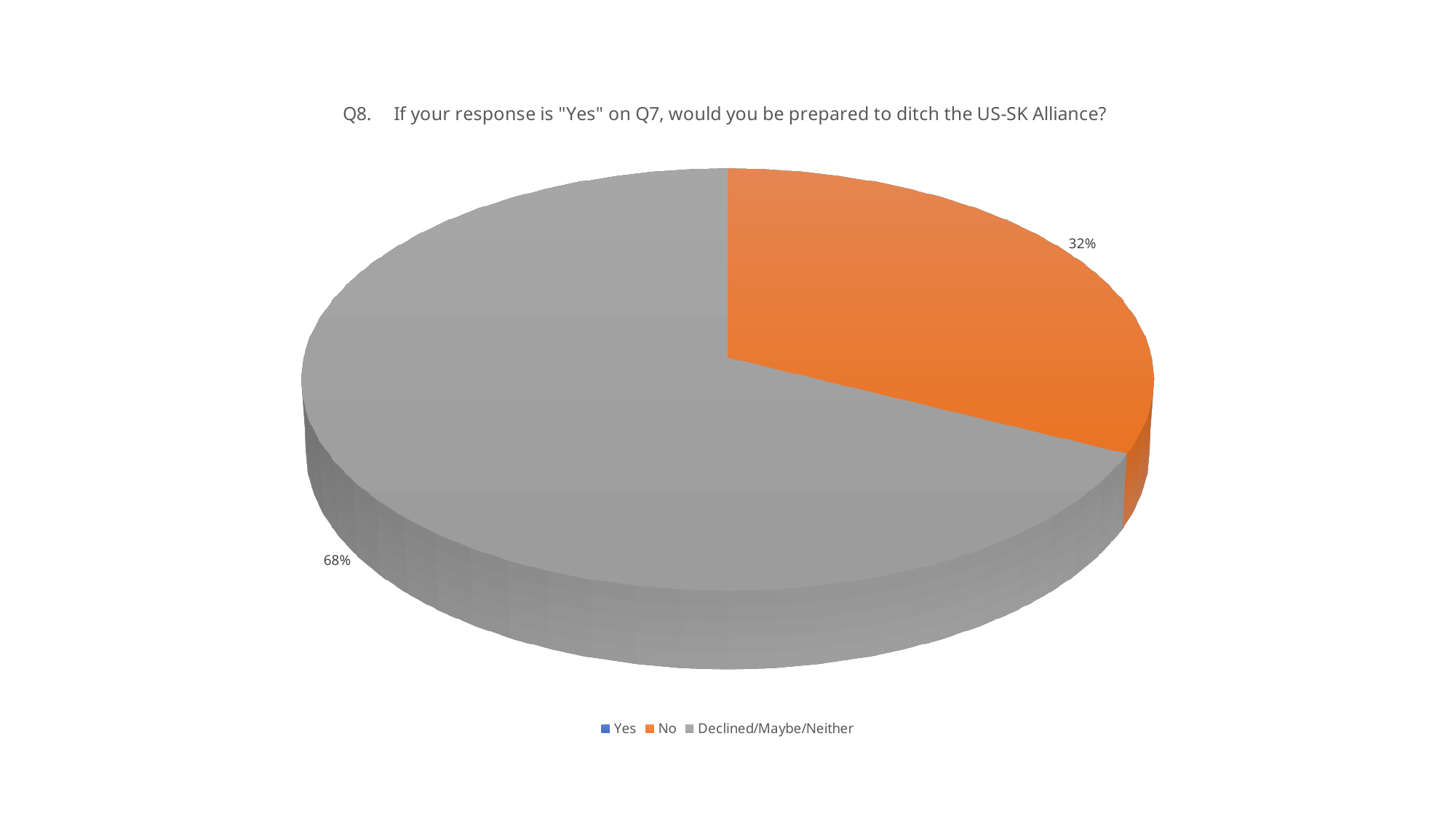
How many entries does the legend list? 3 Which response category has the largest share of the pie? Declined/Maybe/Neither What is the title of the chart? Q8. If your response is "Yes" on Q7, would you be prepared to ditch the US-SK Alliance? What percentage of responses are "No"? 32% What type of chart is shown on the slide? Pie chart What colour is the "No" slice? Orange Which of the two visible slices is larger, "No" or "Declined/Maybe/Neither"? Declined/Maybe/Neither What percentage of responses are "Declined/Maybe/Neither"? 68% Is the share for "Declined/Maybe/Neither" greater or less than 50%? greater What is the difference in percentage points between the "Declined/Maybe/Neither" slice and the "No" slice? 36 Is the share for "No" greater or less than 50%? less